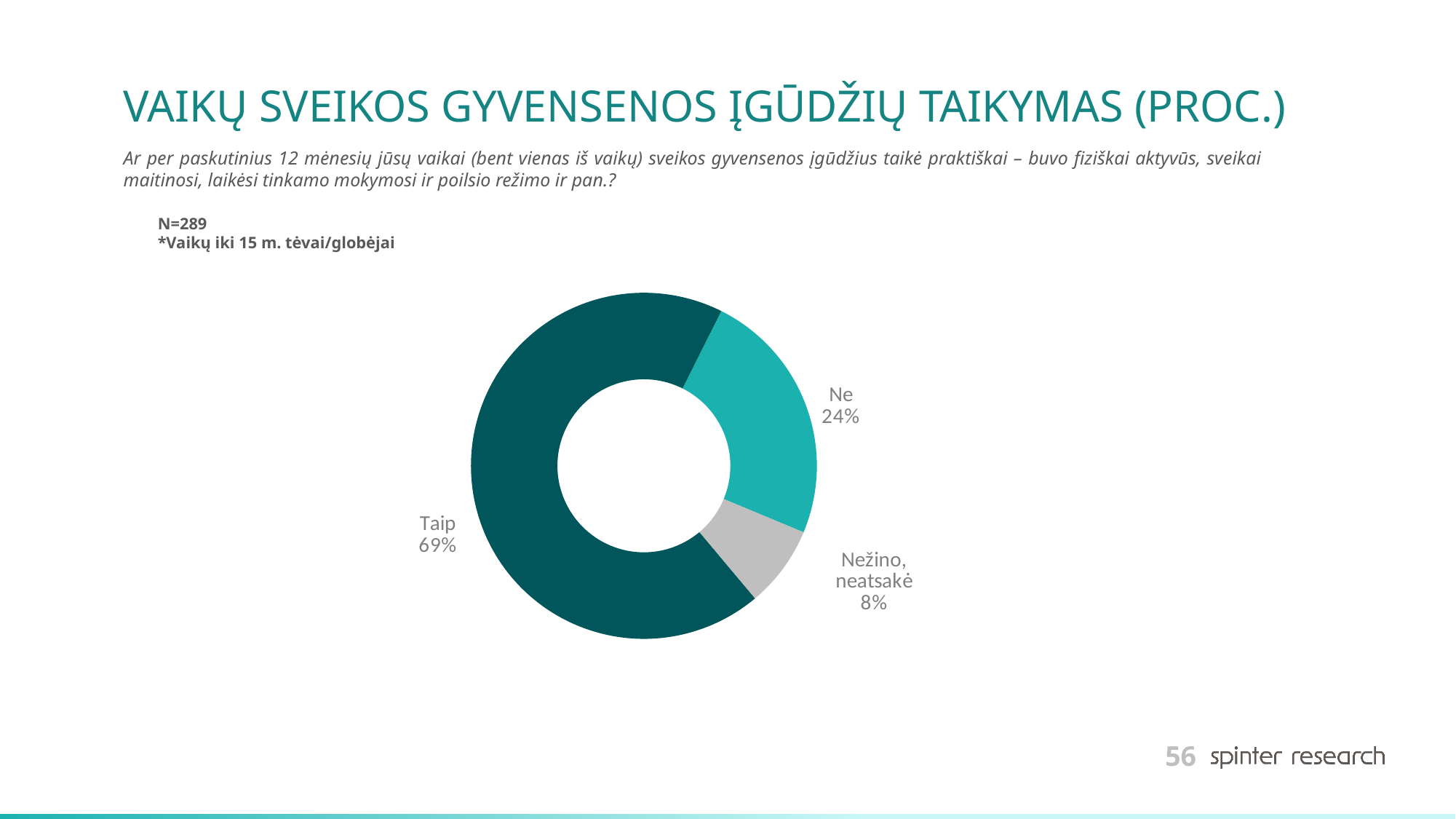
What percentage of respondents answered "Taip"? 69% Which is larger, the share for "Ne" or the share for "Nežino, neatsakė"? Ne What percentage of respondents answered "Nežino, neatsakė"? 8% How many categories are shown in the chart? 3 Which category has the largest share of the chart? Taip What is the title of the slide? VAIKŲ SVEIKOS GYVENSENOS ĮGŪDŽIŲ TAIKYMAS (PROC.) What percentage of respondents answered "Ne"? 24% What is the difference in percentage points between "Ne" and "Nežino, neatsakė"? 16 What is the sample size (N) stated on the slide? N=289 Which category has the smallest share of the chart? Nežino, neatsakė What kind of chart is shown on the slide? Doughnut (pie) chart What is the difference in percentage points between "Taip" and "Ne"? 45